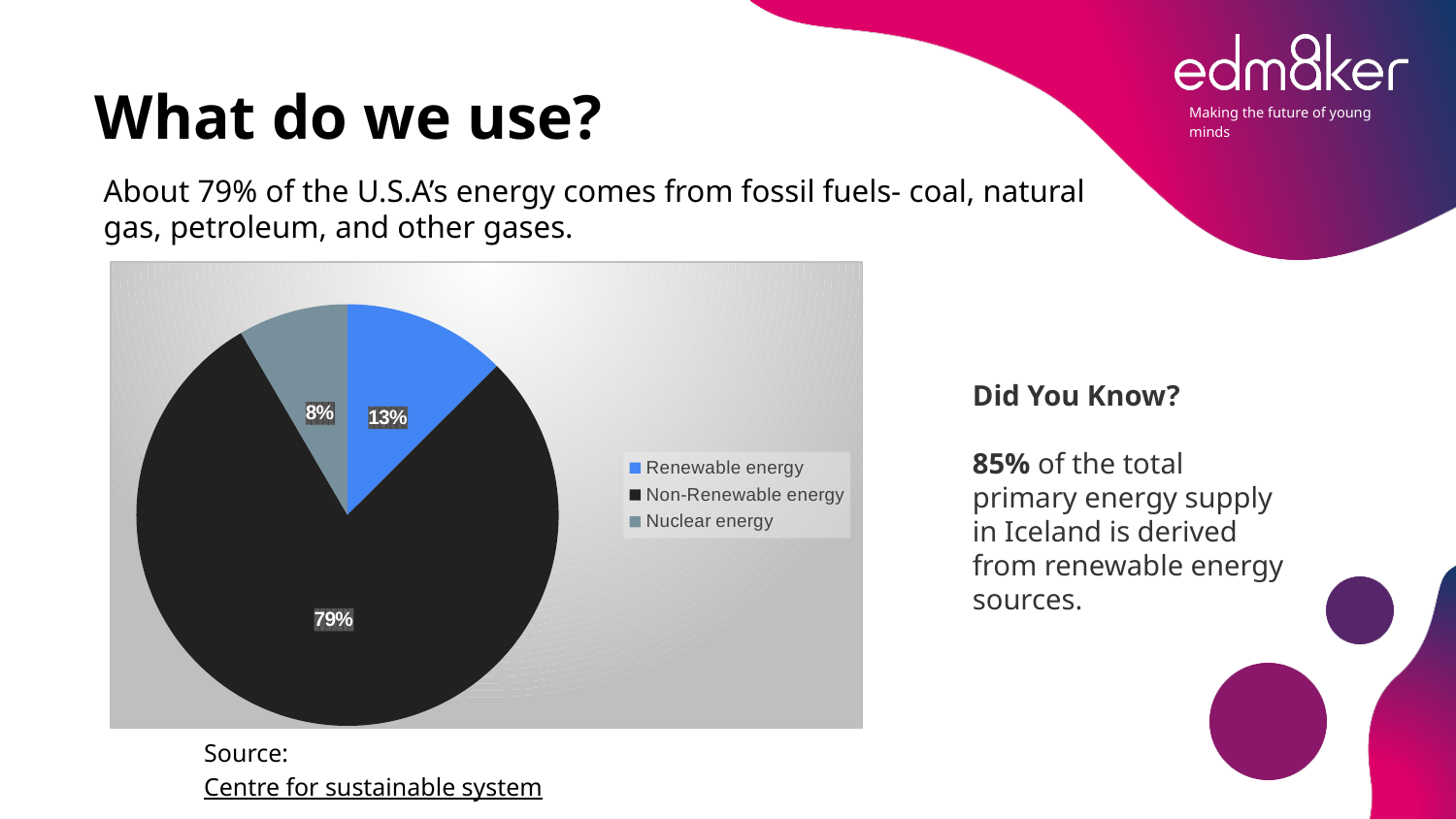
How many categories does the pie chart show? 3 What share of the pie does Nuclear energy represent? 8% What is the difference in percentage points between Non-Renewable energy and Renewable energy? 66% What is the difference in percentage points between Renewable energy and Nuclear energy? 5% What colour is the Non-Renewable energy slice in the pie chart? black Which legend entry is shown in blue? Renewable energy Which energy category has the largest slice of the pie? Non-Renewable energy Which is larger, the Renewable energy slice or the Nuclear energy slice? Renewable energy What share of the pie does Renewable energy represent? 13% What kind of chart is shown on the slide? pie chart Which energy category has the smallest slice of the pie? Nuclear energy What share of the pie does Non-Renewable energy represent? 79%